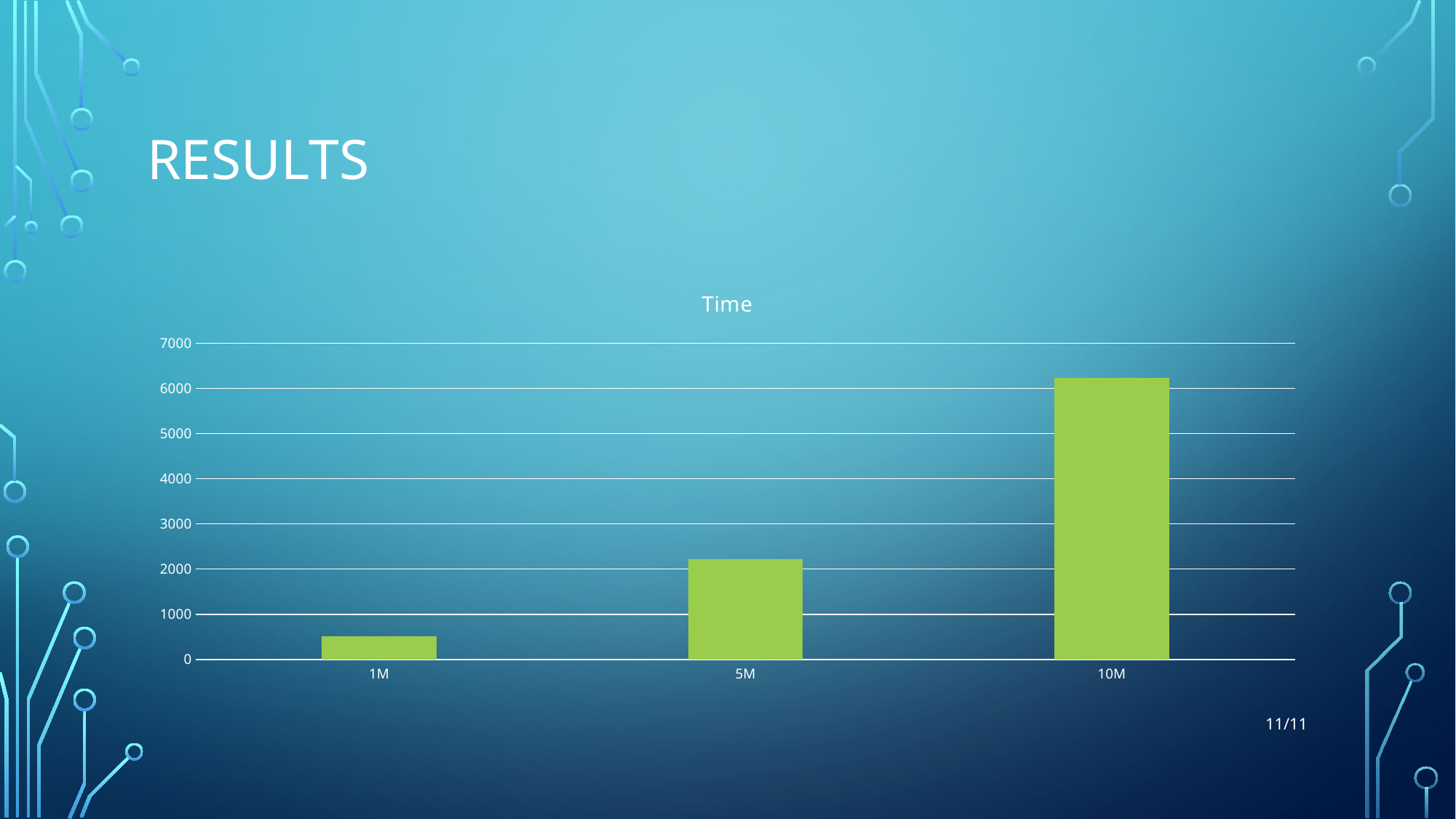
Which is larger, the value for 5M or the value for 1M? 5M Is the value for 10M greater or less than 7000? less Is the value for 1M greater or less than 1000? less Is the value for 5M greater or less than 2000? greater Do the values rise or fall from 1M to 10M along the x axis? rise What type of chart is shown on the slide? bar chart What colour are the bars in the chart? green What is the title of the chart? Time Which category has the highest value in the chart? 10M How many categories are shown on the x axis of the chart? 3 Which category has the lowest value in the chart? 1M